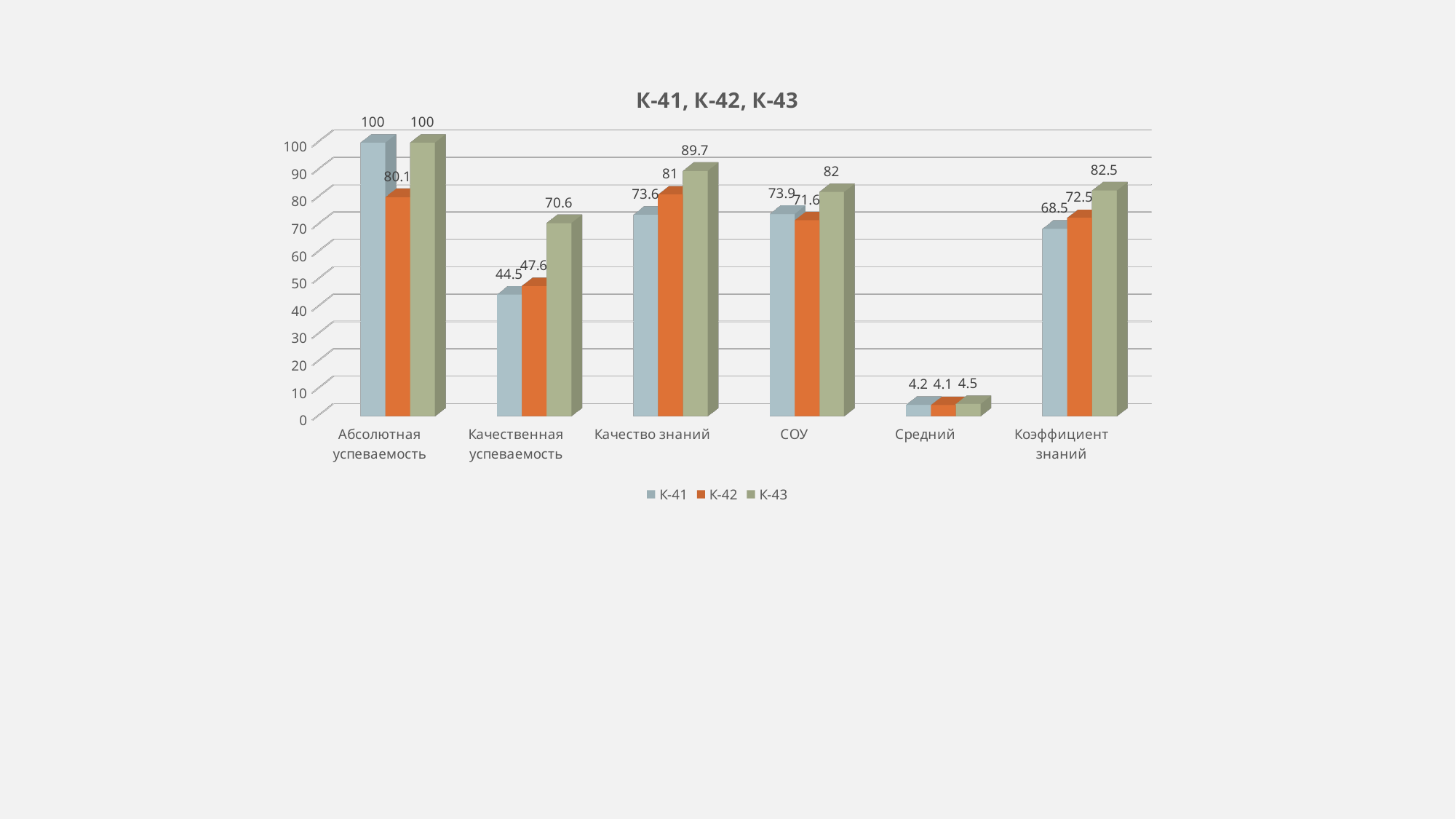
Which series has the highest value in the Качество знаний category? К-43 What is the value for К-43 in the Качественная успеваемость category? 70.6 Which is larger in the Коэффициент знаний category: the value for К-42 or the value for К-43? К-43 Which series has the lowest value in the СОУ category? К-42 What is the difference between the К-43 and К-41 values in the Качественная успеваемость category? 26.1 What kind of chart is shown on the slide? Bar chart What is the value for К-42 in the Абсолютная успеваемость category? 80.1 What is the value for К-41 in the Коэффициент знаний category? 68.5 What is the title of the chart? К-41, К-42, К-43 How many categories are shown on the x axis? 6 What is the value for К-42 in the Средний category? 4.1 How many series does the legend list? 3